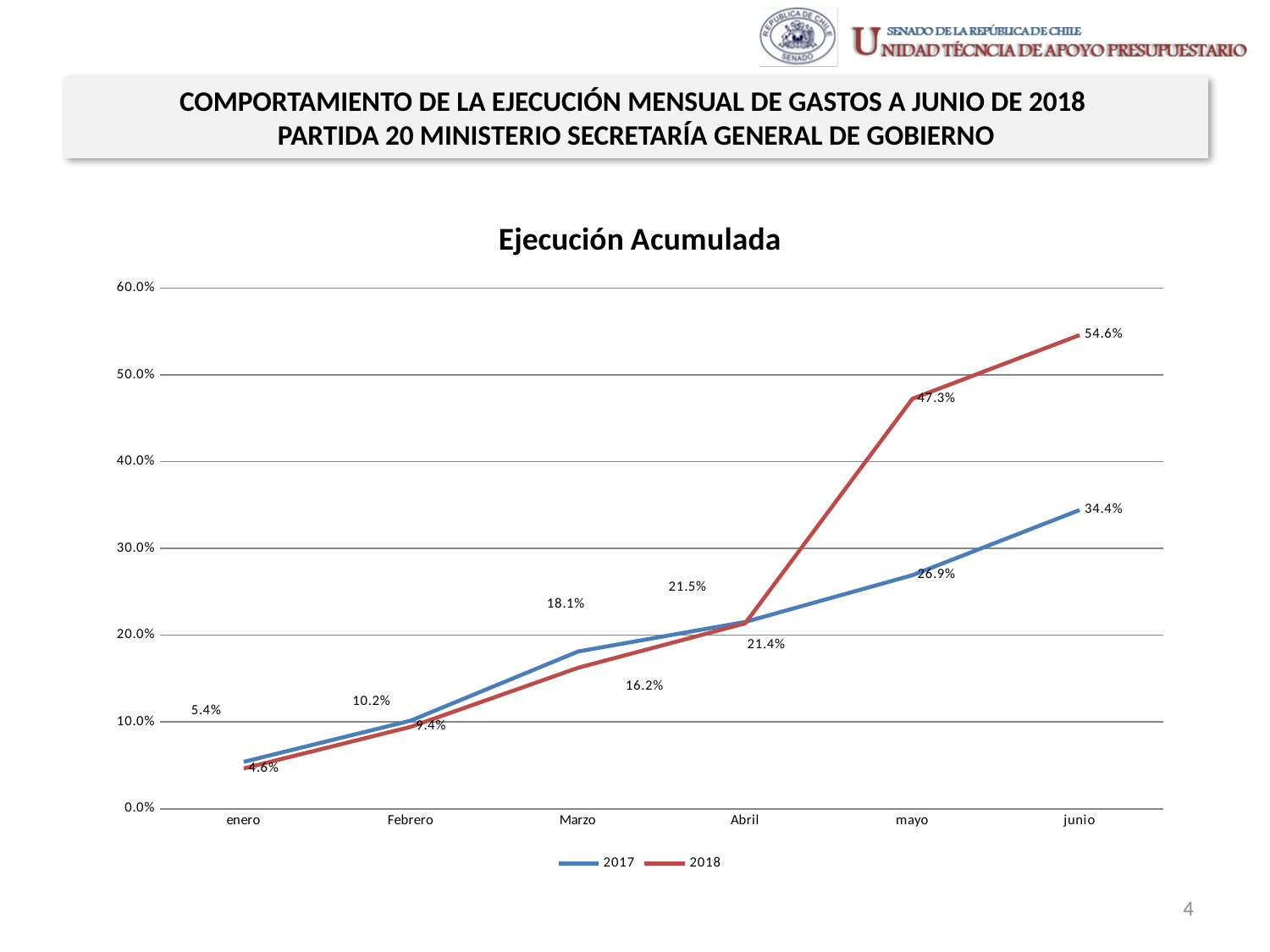
What is the value for 2018 in mayo? 47.3% What is the value for 2017 in Marzo? 18.1% What type of chart is shown on the slide? line chart In which month is the 2018 series lowest? enero What is the difference between the 2018 and 2017 values in junio? 20.2% What is the value for 2018 in junio? 54.6% Does the 2017 series rise or fall from enero to junio? rise How many series does the legend list? 2 How many months are shown on the x axis? 6 What is the title of the chart? Ejecución Acumulada Which series has the higher value in mayo, 2017 or 2018? 2018 What is the value for 2017 in junio? 34.4%